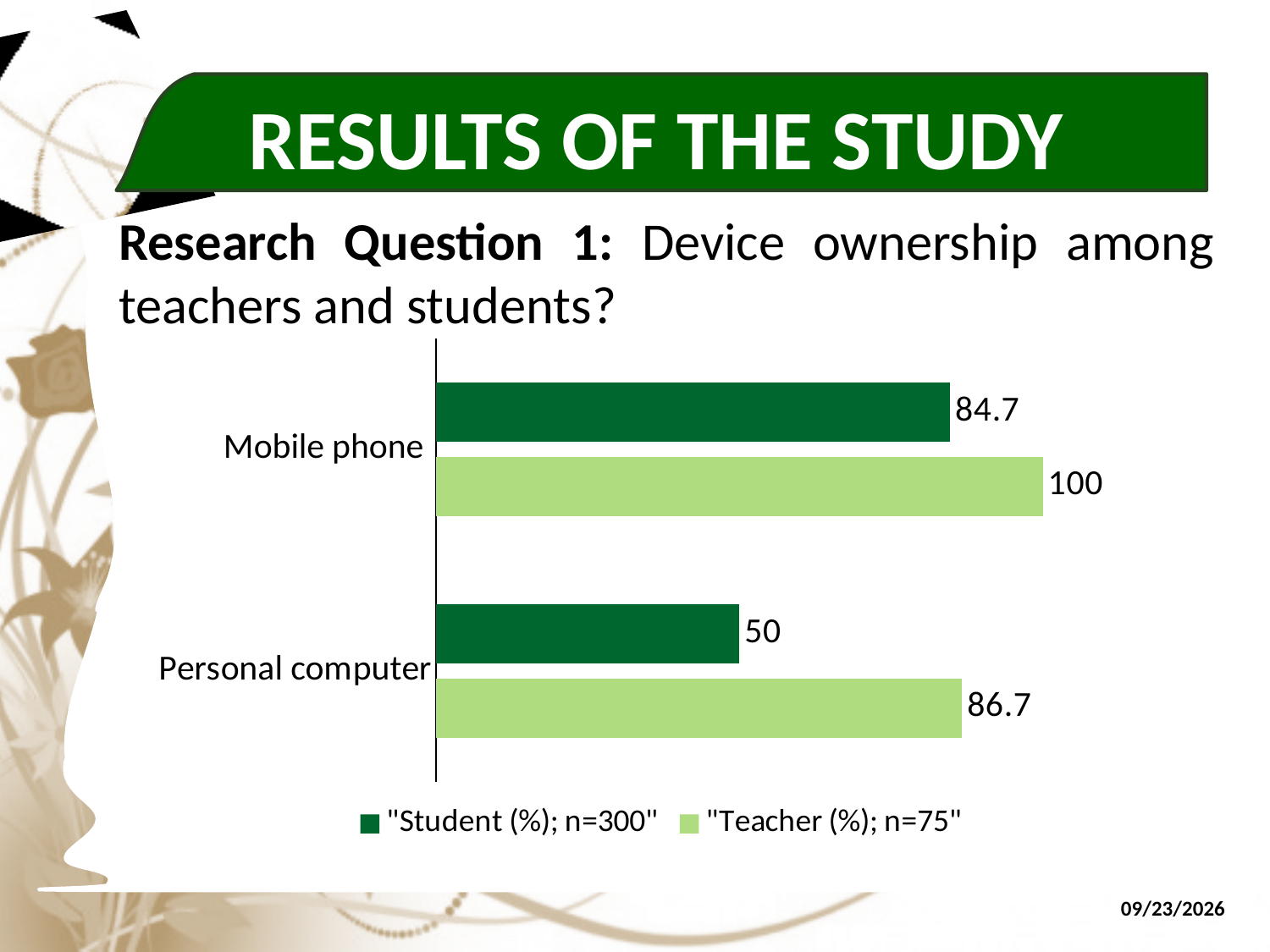
How many categories are shown on the chart? 2 For Personal computer, which is larger: the Student (%) value or the Teacher (%) value? Teacher (%) How many series does the legend list? 2 What kind of chart is shown on the slide? Bar chart What is the Teacher (%) value for Mobile phone? 100 What is the difference between the Teacher (%) and Student (%) values for Personal computer? 36.7 What is the Student (%) value for Mobile phone? 84.7 What is the Student (%) value for Personal computer? 50 What is the Teacher (%) value for Personal computer? 86.7 Which category has the lowest Teacher (%) value? Personal computer Which category has the highest Student (%) value? Mobile phone What is the difference between the Teacher (%) and Student (%) values for Mobile phone? 15.3